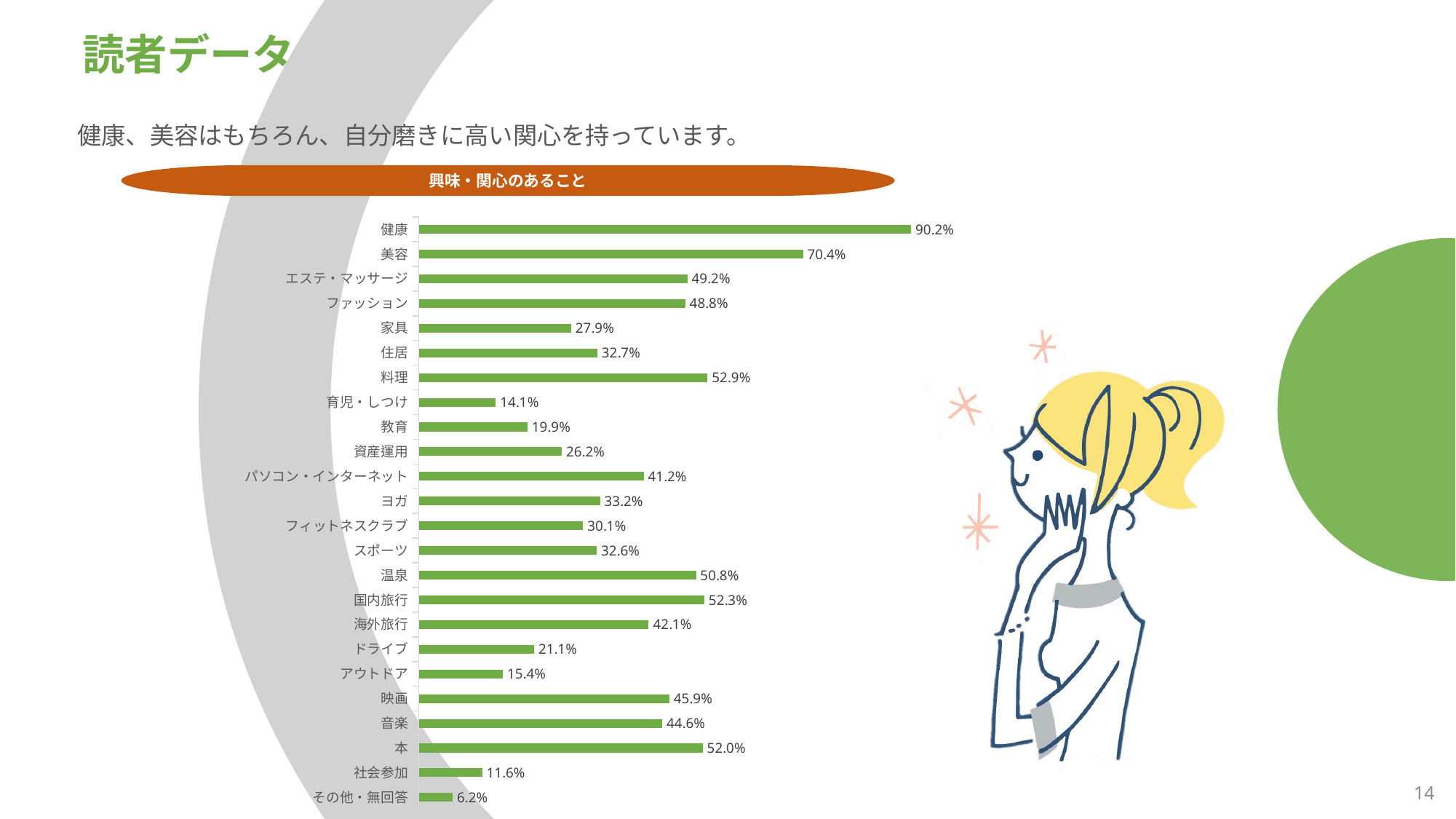
What is the value for 温泉? 50.8% How many categories are plotted in the chart? 24 Which category has the highest value in the chart? 健康 What kind of chart is shown on the slide? Bar chart What is the difference between the values for 国内旅行 and 海外旅行? 10.2 percentage points What is the title shown above the chart? 興味・関心のあること What percentage is shown for パソコン・インターネット? 41.2% What is the difference between the values for 健康 and 美容? 19.8 percentage points Which category has the lowest value in the chart? その他・無回答 What is the value for 健康 in the 興味・関心のあること chart? 90.2% Which is larger, the value for 映画 or the value for 音楽? 映画 Which is larger, the value for ヨガ or the value for フィットネスクラブ? ヨガ